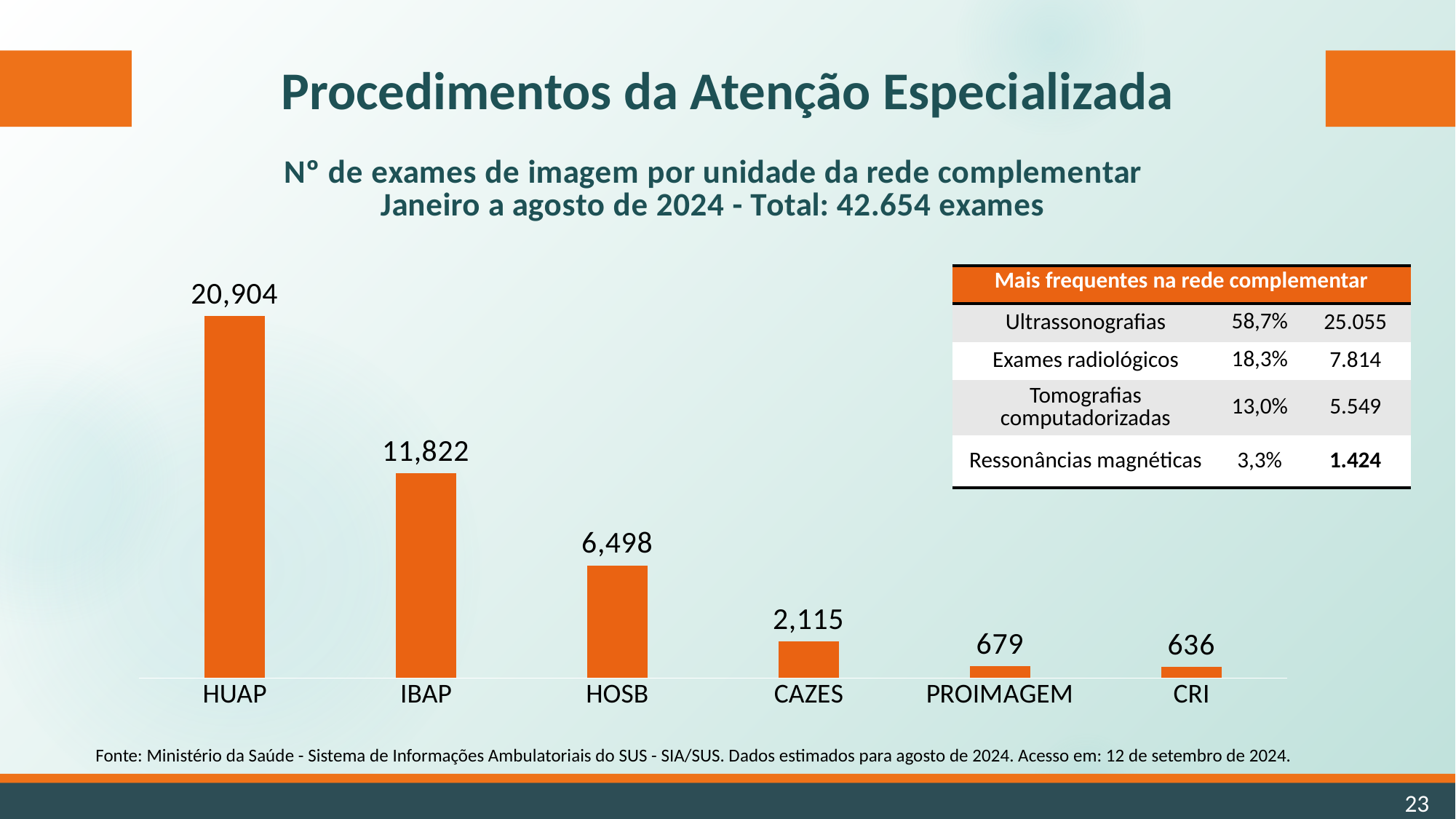
What is the value for PROIMAGEM? 679 What is the value for HUAP? 20,904 Which unit has the lowest number of exams? CRI What is the value for IBAP? 11,822 What is the value for CAZES? 2,115 Which unit has the highest number of exams? HUAP How many units are shown on the chart? 6 What kind of chart is shown on the slide? Bar chart Do the values rise or fall from left to right along the x axis? Fall Which is larger, the value for HOSB or the value for CAZES? HOSB What is the value for HOSB? 6,498 What is the difference between the values for HUAP and IBAP? 9,082